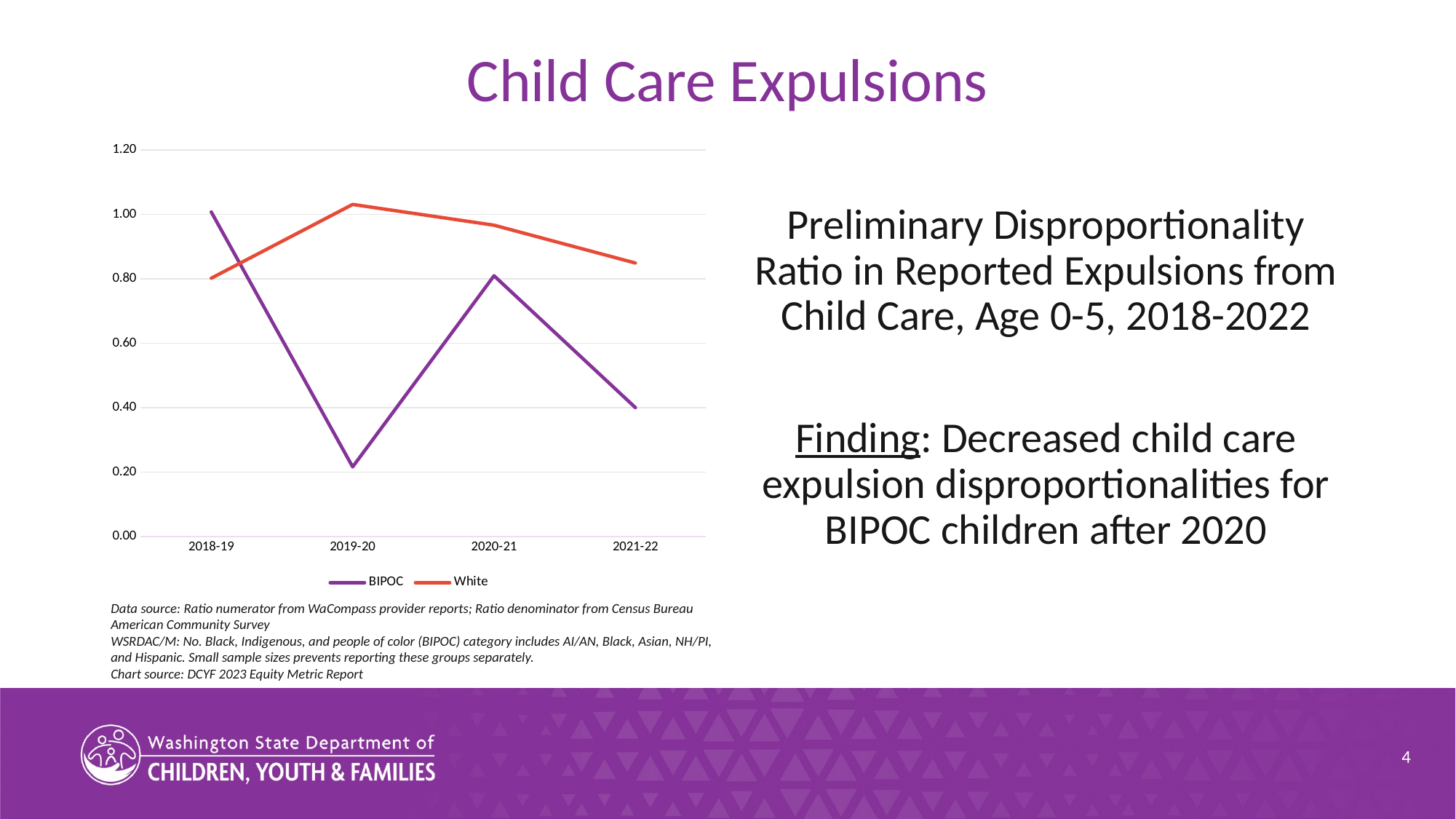
How many series does the chart legend list? 2 Is the BIPOC value for 2018-19 greater or less than 0.80? greater In which school year is the BIPOC line at its highest point? 2018-19 Is the White value for 2021-22 greater or less than 1.00? less In which school year is the White line at its highest point? 2019-20 Does the White line rise or fall from 2019-20 to 2021-22? fall What kind of chart is shown on the slide? line chart In which school year is the BIPOC line at its lowest point? 2019-20 How many school years are plotted along the x axis of the chart? 4 Is the BIPOC value for 2019-20 greater or less than 0.40? less In 2019-20, which series has the higher value, BIPOC or White? White In 2018-19, which series has the higher value, BIPOC or White? BIPOC